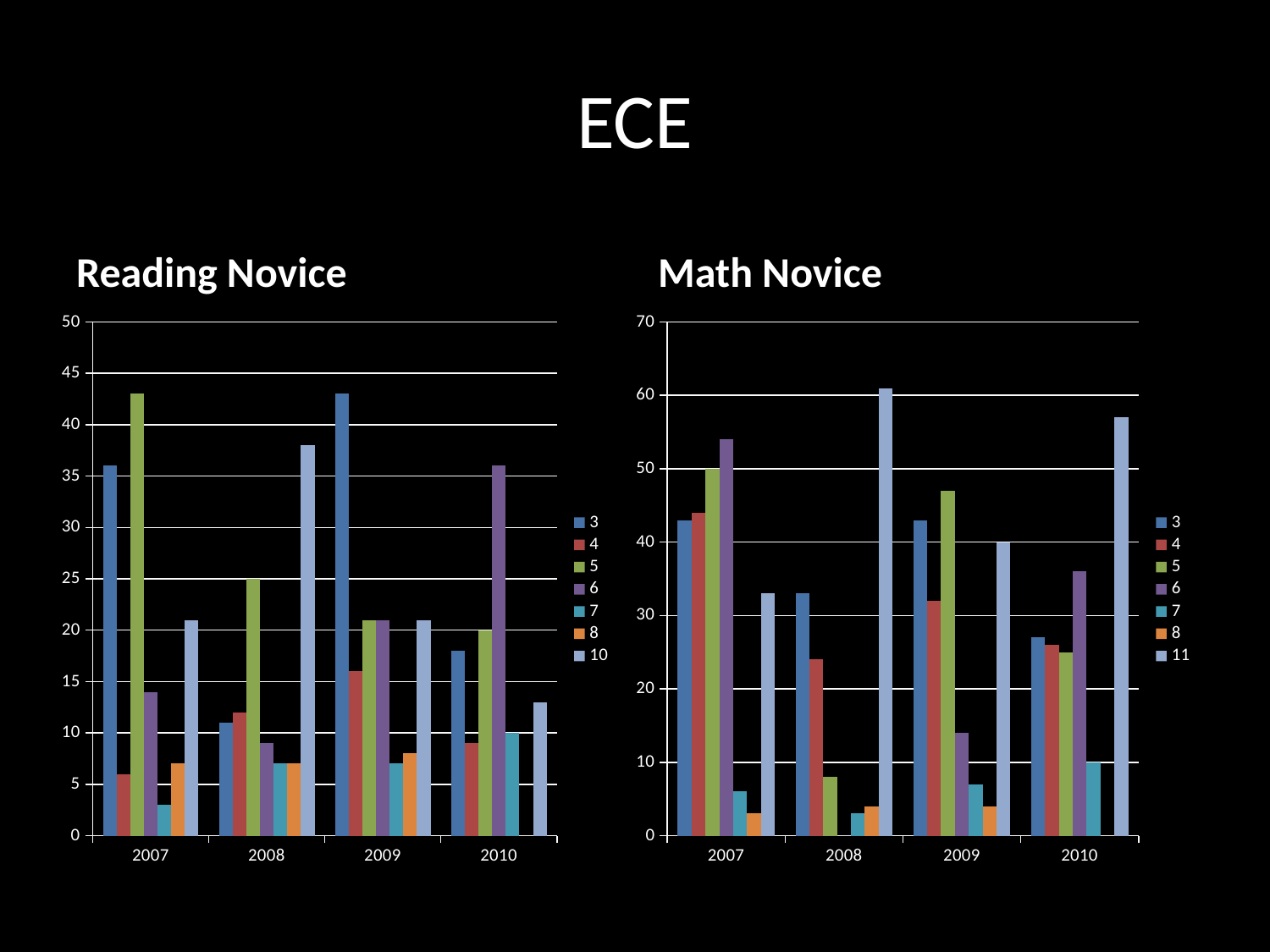
In the Reading Novice chart, is the value for series 3 in 2009 greater or less than 40? greater In the Math Novice chart, which series has the highest value in 2008? 11 In the Math Novice chart, is the value for series 6 in 2007 greater or less than 50? greater How many years are shown on the x axis of the Reading Novice chart? 4 What is the last legend entry in the Reading Novice chart? 10 In the Reading Novice chart, which series has the lowest value in 2007? 7 How many series does the legend of the Math Novice chart list? 7 In the Reading Novice chart, which series has the highest value in 2007? 5 In the Reading Novice chart, which is larger in 2009: series 3 or series 10? series 3 In the Math Novice chart, is the value for series 5 in 2008 greater or less than 10? less What kind of chart is the Reading Novice chart? bar chart In the Math Novice chart, which is larger in 2010: series 11 or series 6? series 11